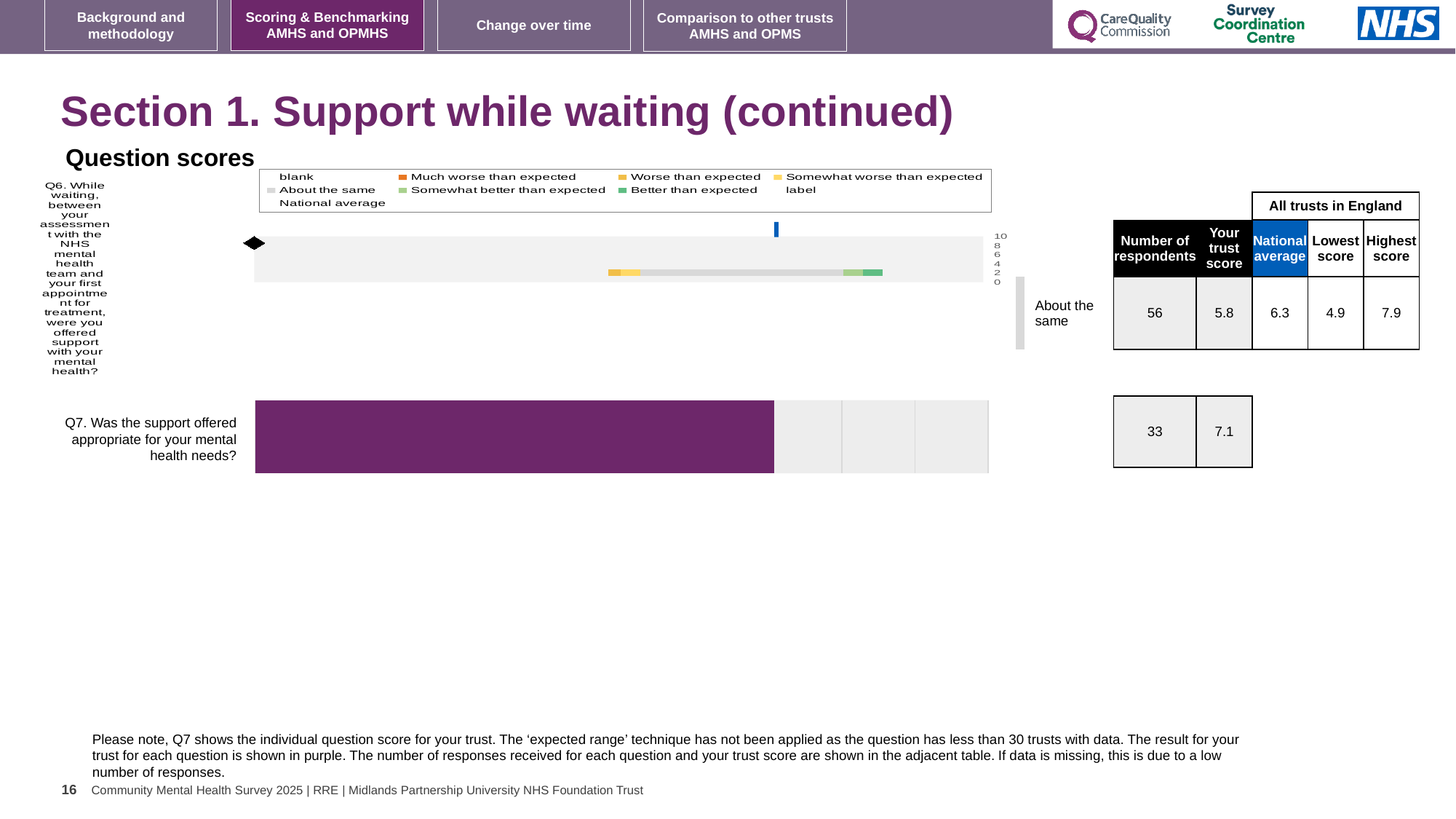
How many more respondents answered Q6 than Q7? 23 What is the trust score for Q7 (was the support offered appropriate for your mental health needs)? 7.1 Is the purple bar for Q7 greater or less than 6 on the score axis? greater How is the trust's Q6 score categorised relative to the expected range? About the same What is the trust score for Q6 (support while waiting between assessment and first appointment)? 5.8 What is the difference between the national average and the trust score for Q6? 0.5 What is the national average score for Q6? 6.3 What is the difference between the highest and lowest scores for Q6 across all trusts in England? 3.0 What is the highest score among all trusts in England for Q6? 7.9 What is the lowest score among all trusts in England for Q6? 4.9 How many respondents answered Q7? 33 Which is larger for Q6: the trust score or the national average? National average